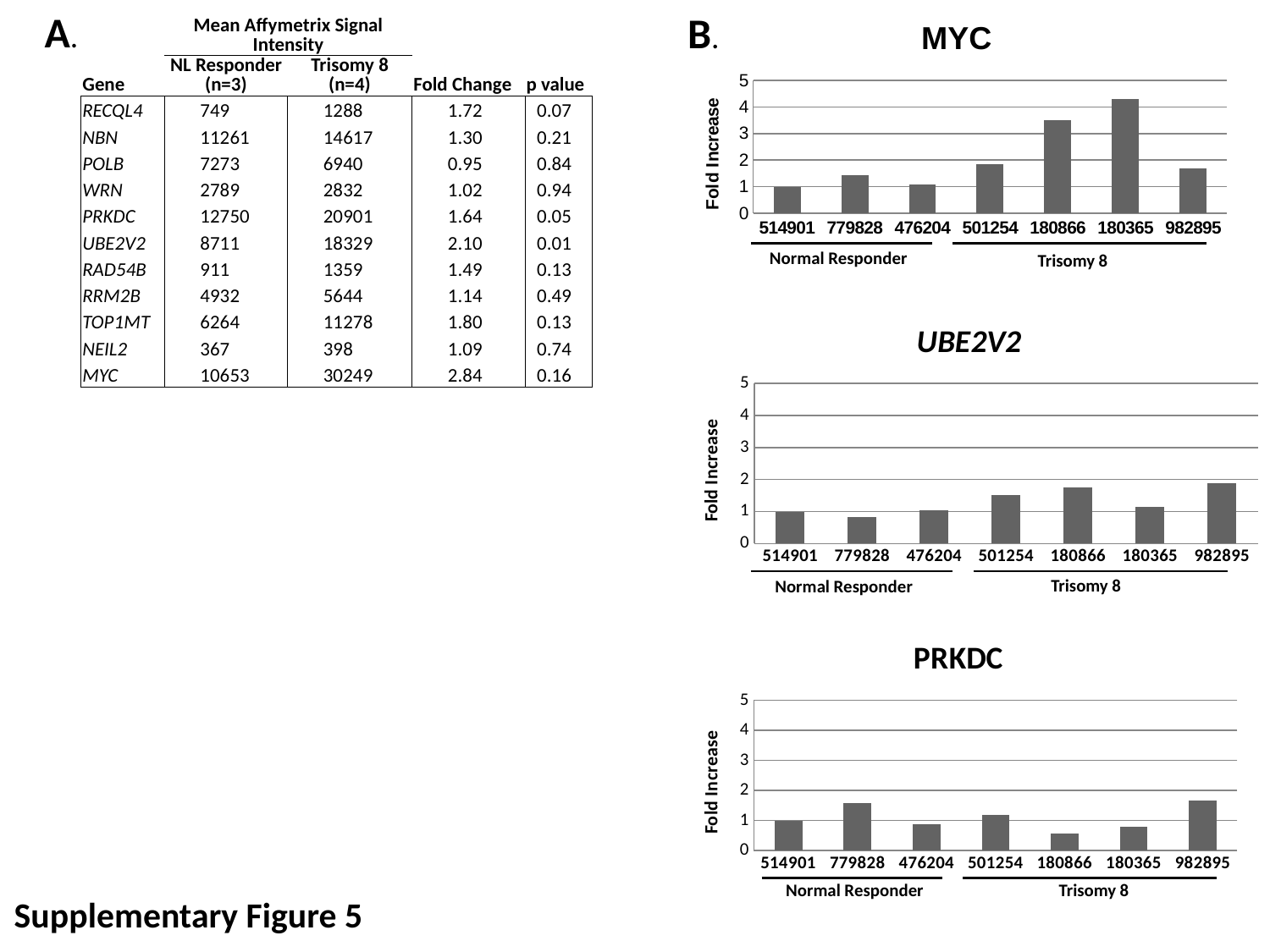
In the PRKDC chart, is the value for 982895 greater or less than 1? greater What kind of chart is the UBE2V2 chart? bar chart In the MYC chart, is the value for 180866 greater or less than 3? greater In the MYC chart, which sample has the highest fold increase? 180365 In the UBE2V2 chart, is the value for 982895 greater or less than 1? greater In the UBE2V2 chart, which sample has the lowest fold increase? 779828 In the MYC chart, which is larger, the value for 180866 or the value for 982895? 180866 What is the y-axis label of the PRKDC chart? Fold Increase In the PRKDC chart, which is larger, the value for 779828 or the value for 476204? 779828 In the PRKDC chart, which sample has the lowest fold increase? 180866 How many bars are plotted in the MYC chart? 7